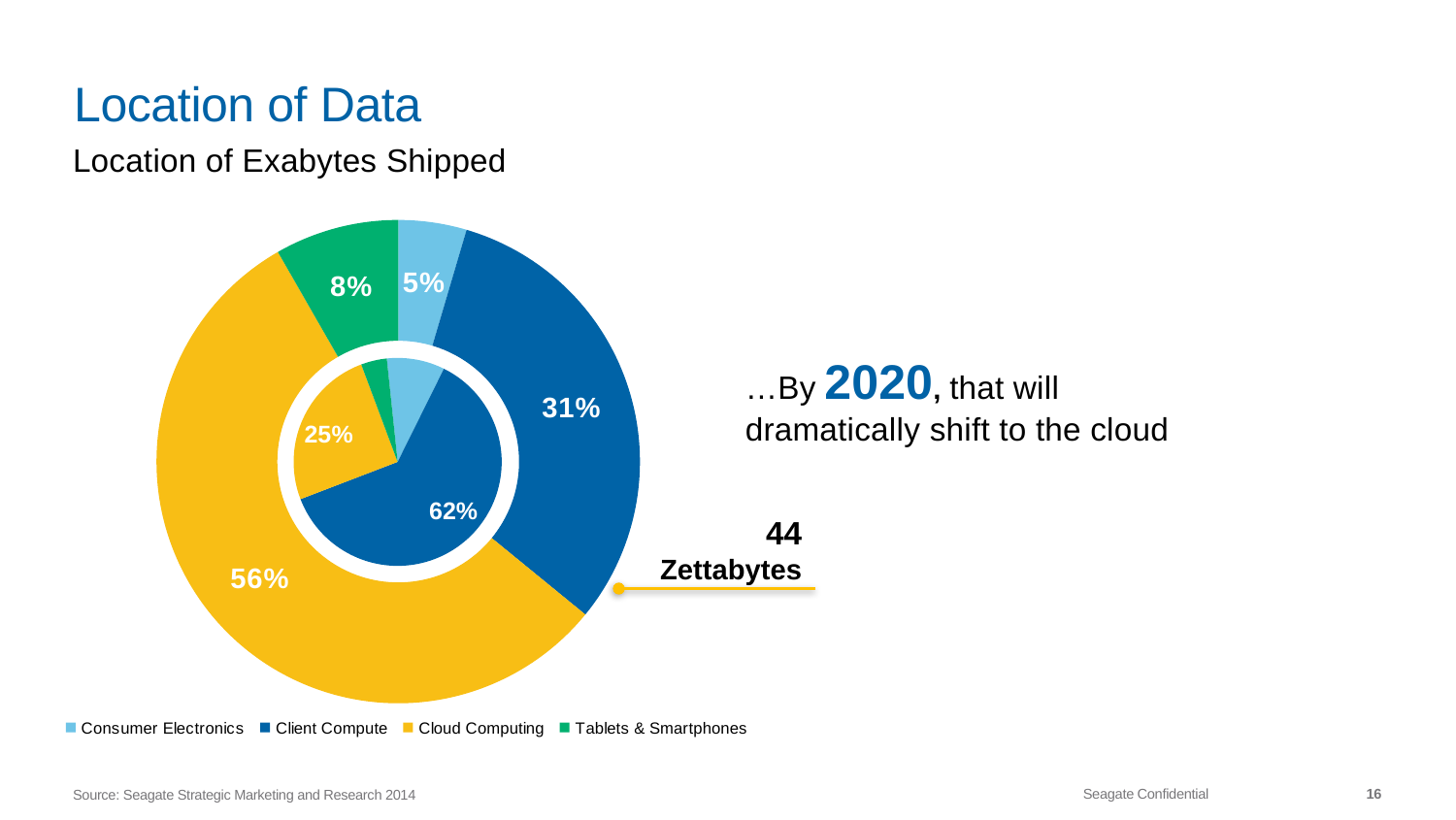
In the outer ring, what percentage is shown for Consumer Electronics? 5% Which category is labelled with the larger share in the inner ring, Client Compute or Cloud Computing? Client Compute In the inner ring, what percentage is shown for Cloud Computing? 25% In the outer ring, what percentage is shown for Cloud Computing? 56% Which category has the smallest share in the outer ring? Consumer Electronics In the outer ring, what percentage is shown for Client Compute? 31% In the inner ring, what percentage is shown for Client Compute? 62% What is the difference between the Cloud Computing share in the outer ring and the Cloud Computing share in the inner ring? 31% What kind of chart is shown on the slide? Doughnut chart Which category has the largest share in the outer ring? Cloud Computing How many categories does the legend list? 4 In the outer ring, what percentage is shown for Tablets & Smartphones? 8%